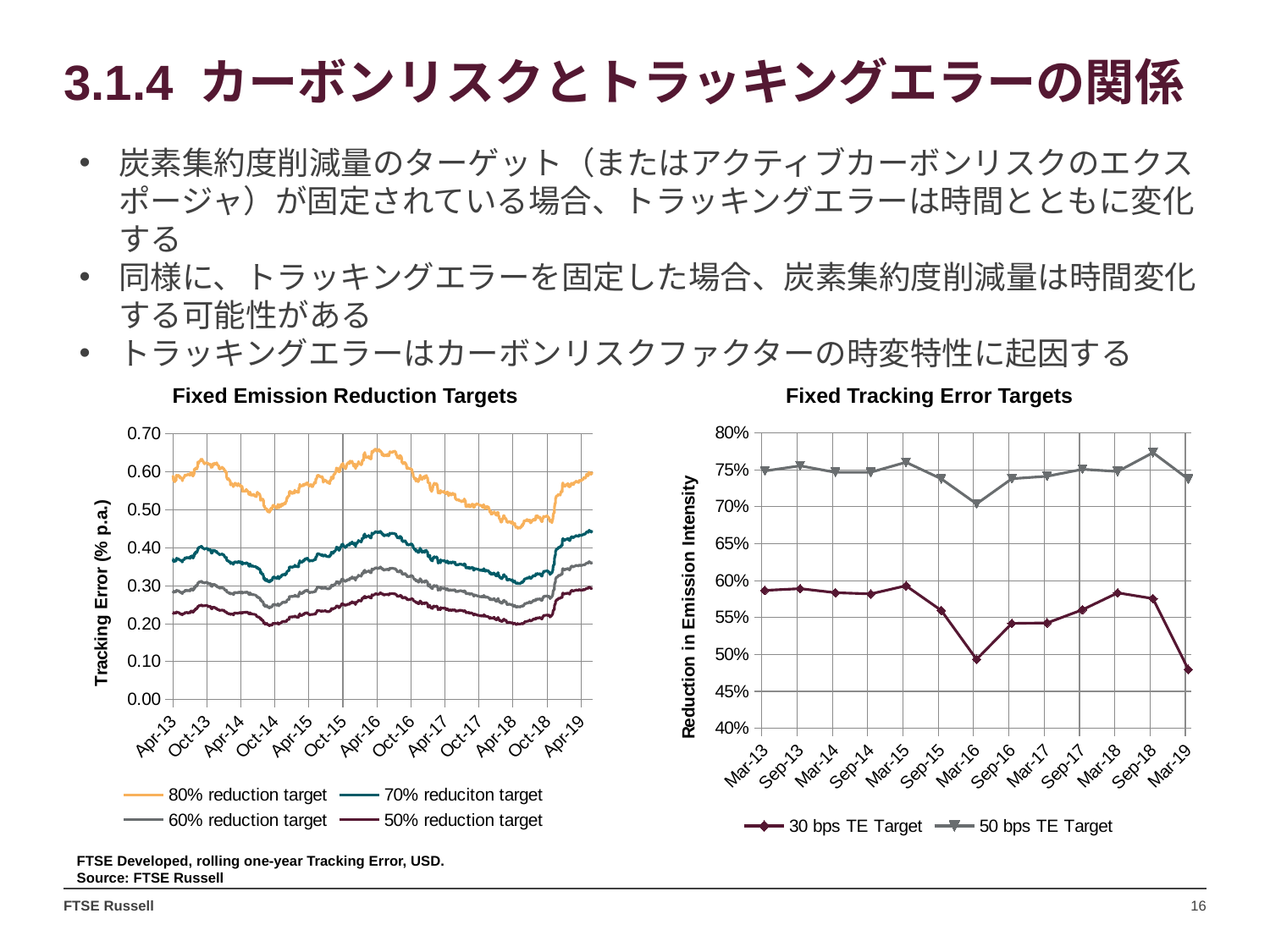
What type of chart is the "Fixed Emission Reduction Targets" chart? line chart In the "Fixed Tracking Error Targets" chart, which series is higher, 30 bps TE Target or 50 bps TE Target? 50 bps TE Target In the "Fixed Emission Reduction Targets" chart, which series has the highest tracking error throughout the period? 80% reduction target What is the y-axis label of the "Fixed Tracking Error Targets" chart? Reduction in Emission Intensity In the "Fixed Tracking Error Targets" chart, is the value of the 50 bps TE Target series at Mar-16 greater or less than 75%? less In the "Fixed Emission Reduction Targets" chart, which series has the lowest tracking error throughout the period? 50% reduction target In the "Fixed Emission Reduction Targets" chart, is the value of the 50% reduction target series at Oct-14 greater or less than 0.30? less In the "Fixed Tracking Error Targets" chart, is the value of the 30 bps TE Target series at Mar-19 greater or less than 50%? less How many series does the legend of the "Fixed Emission Reduction Targets" chart list? 4 In the "Fixed Tracking Error Targets" chart, at which date does the 30 bps TE Target series reach its lowest value? Mar-19 How many series does the legend of the "Fixed Tracking Error Targets" chart list? 2